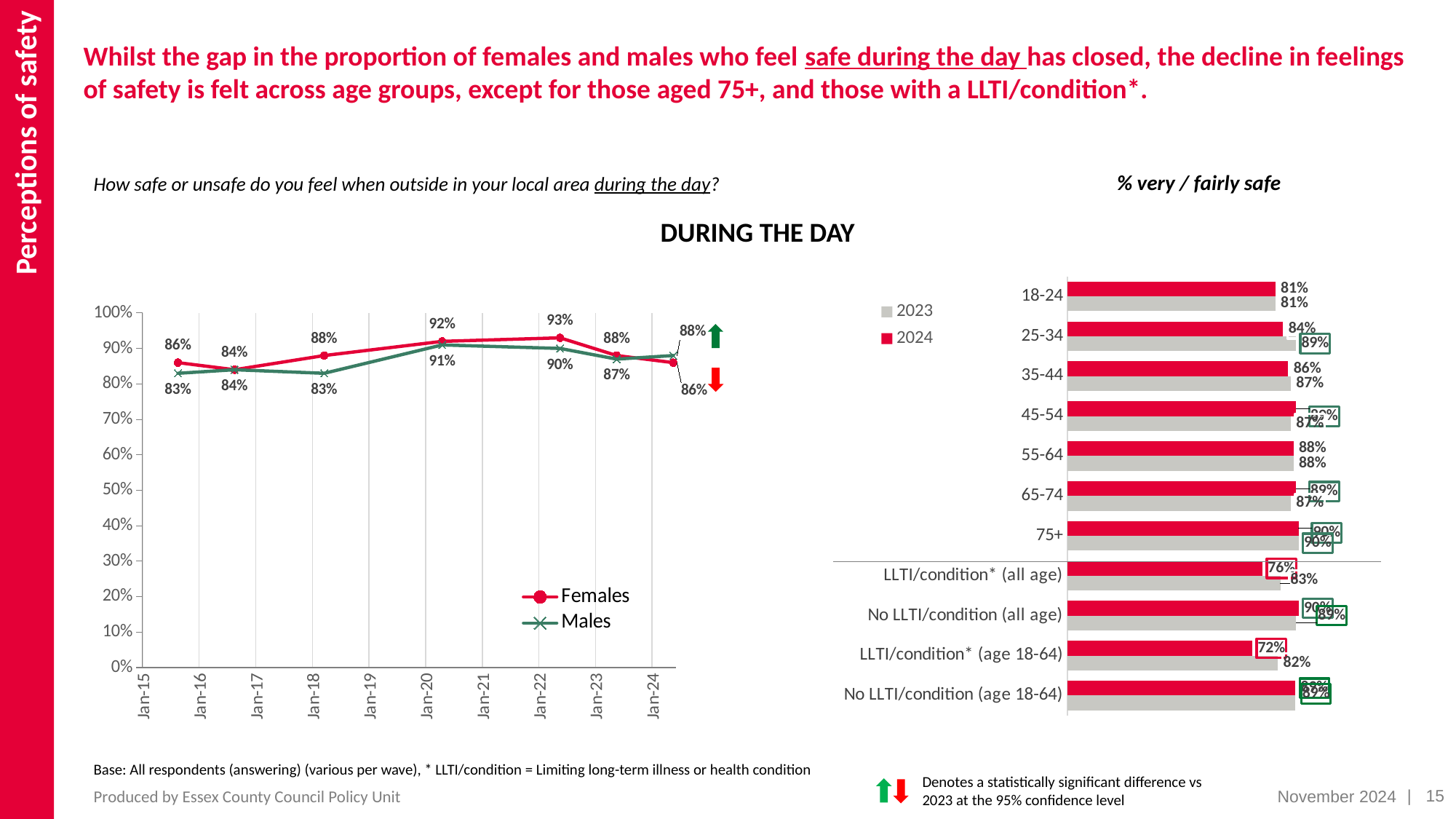
In the bar chart on the right, what is the difference between the 2023 value (83%) and the 2024 value (76%) for LLTI/condition* (all age)? 7 percentage points What are the two legend entries of the bar chart on the right of the slide? 2023 and 2024 In the 'DURING THE DAY' line chart, what is the lowest value shown for Males? 83% What kind of chart is the chart on the right of the slide showing age groups and LLTI/condition? Bar chart What kind of chart is the 'DURING THE DAY' chart on the left of the slide? Line chart In the bar chart on the right, what is the 2024 value for LLTI/condition* (age 18-64)? 72% In the 'DURING THE DAY' line chart, which series has the higher value at the final (Jan-24) point, Females or Males? Males How many categories are shown on the bar chart on the right of the slide? 11 In the 'DURING THE DAY' line chart, what is the difference between the Females value (92%) and the Males value (91%) at the Jan-20 point? 1 percentage point In the 'DURING THE DAY' line chart, what is the highest value shown for Females? 93% How many series does the legend of the 'DURING THE DAY' line chart list? 2 In the bar chart on the right, what is the 2023 value for the 25-34 age group? 89%